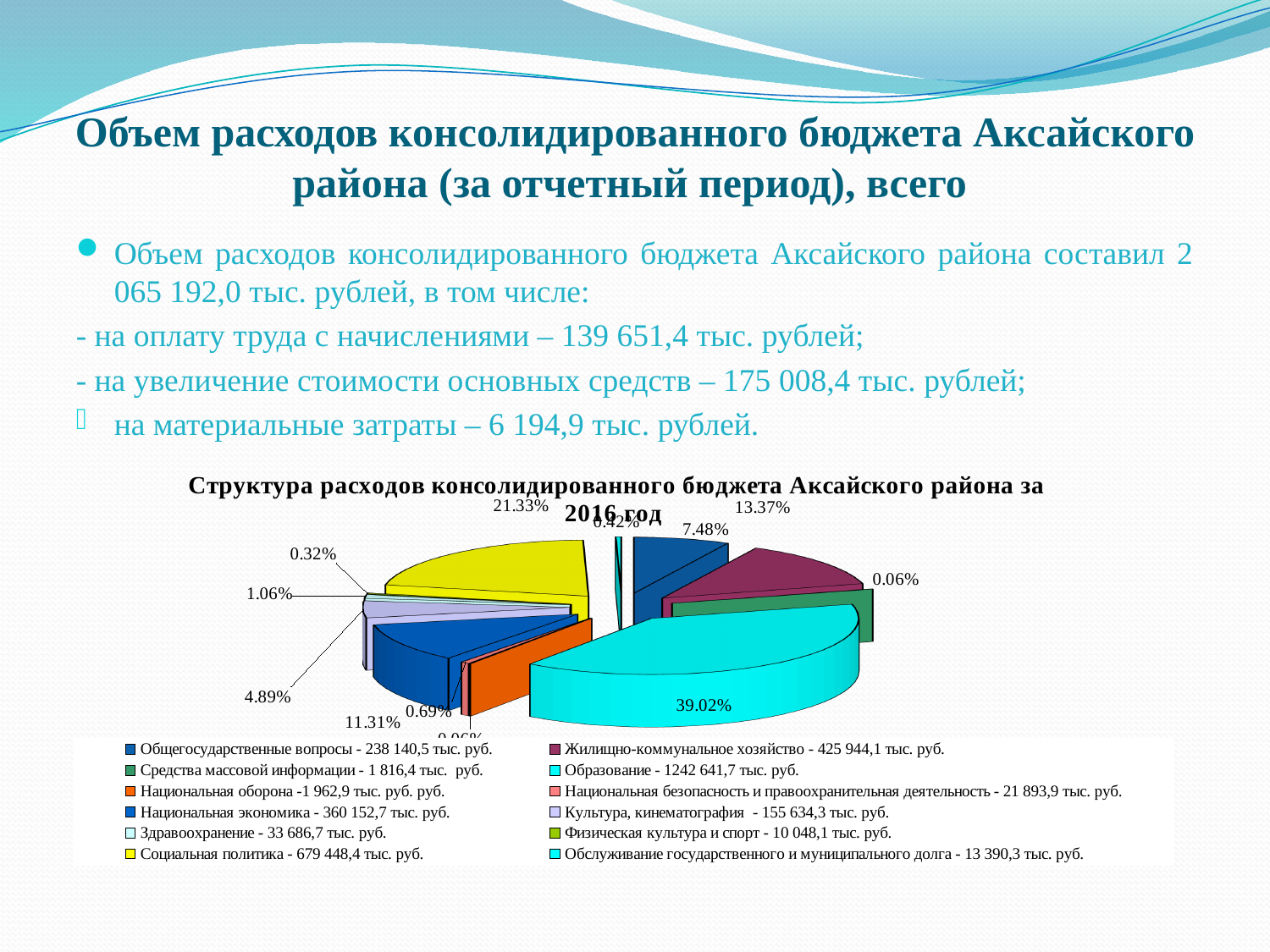
How many categories does the pie chart legend list? 12 What value does the legend give for Здравоохранение? 33 686,7 тыс. руб. Which category has the largest share of the pie? Образование What value does the legend give for Культура, кинематография? 155 634,3 тыс. руб. Which is larger: Жилищно-коммунальное хозяйство or Национальная экономика? Жилищно-коммунальное хозяйство Which category has the smallest value in the legend? Средства массовой информации What value does the legend give for Образование? 1242 641,7 тыс. руб. What is the title of the chart? Структура расходов консолидированного бюджета Аксайского района за 2016 год What share of the pie does Социальная политика take? 21.33% What kind of chart is shown on the slide? Pie chart What is the difference between the legend values for Социальная политика and Национальная экономика? 319 295,7 тыс. руб. What share of the pie does Образование take? 39.02%